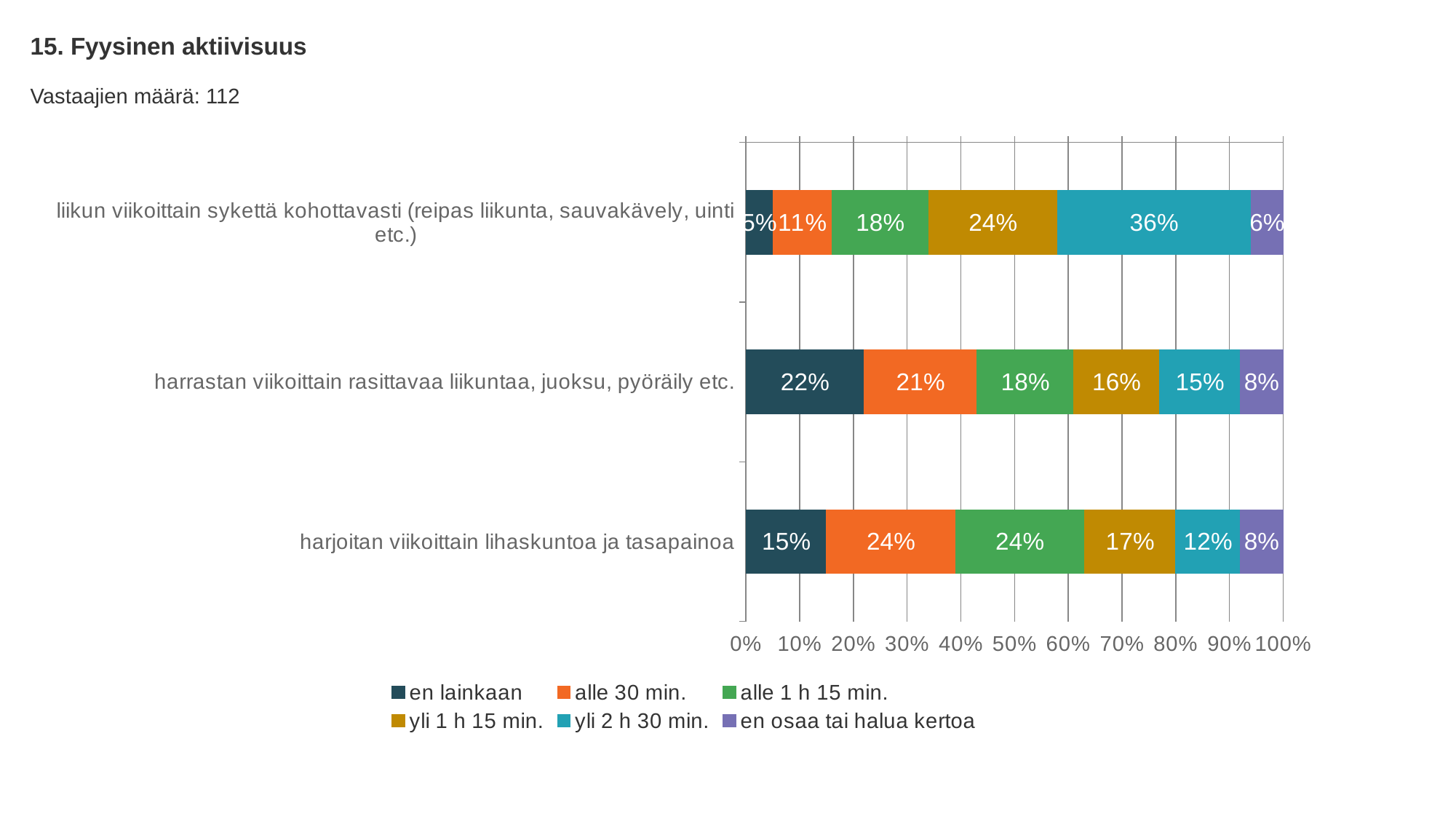
What is the value for "en osaa tai halua kertoa" in the category "harjoitan viikoittain lihaskuntoa ja tasapainoa"? 8% Which category has the lowest value for "en osaa tai halua kertoa"? liikun viikoittain sykettä kohottavasti (reipas liikunta, sauvakävely, uinti etc.) How many categories are plotted on the chart? 3 How many series does the legend list? 6 What is the title of the chart on the slide? 15. Fyysinen aktiivisuus What is the value for "alle 30 min." in the category "harjoitan viikoittain lihaskuntoa ja tasapainoa"? 24% What kind of chart is shown on the slide? stacked bar chart Which is larger: the "en lainkaan" value for "harrastan viikoittain rasittavaa liikuntaa, juoksu, pyöräily etc." or for "harjoitan viikoittain lihaskuntoa ja tasapainoa"? harrastan viikoittain rasittavaa liikuntaa, juoksu, pyöräily etc. What is the value for "yli 2 h 30 min." in the category "liikun viikoittain sykettä kohottavasti (reipas liikunta, sauvakävely, uinti etc.)"? 36% Which category has the highest value for "yli 2 h 30 min."? liikun viikoittain sykettä kohottavasti (reipas liikunta, sauvakävely, uinti etc.) What is the difference between the "yli 1 h 15 min." values for "liikun viikoittain sykettä kohottavasti (reipas liikunta, sauvakävely, uinti etc.)" and "harrastan viikoittain rasittavaa liikuntaa, juoksu, pyöräily etc."? 8% What is the value for "en lainkaan" in the category "harrastan viikoittain rasittavaa liikuntaa, juoksu, pyöräily etc."? 22%